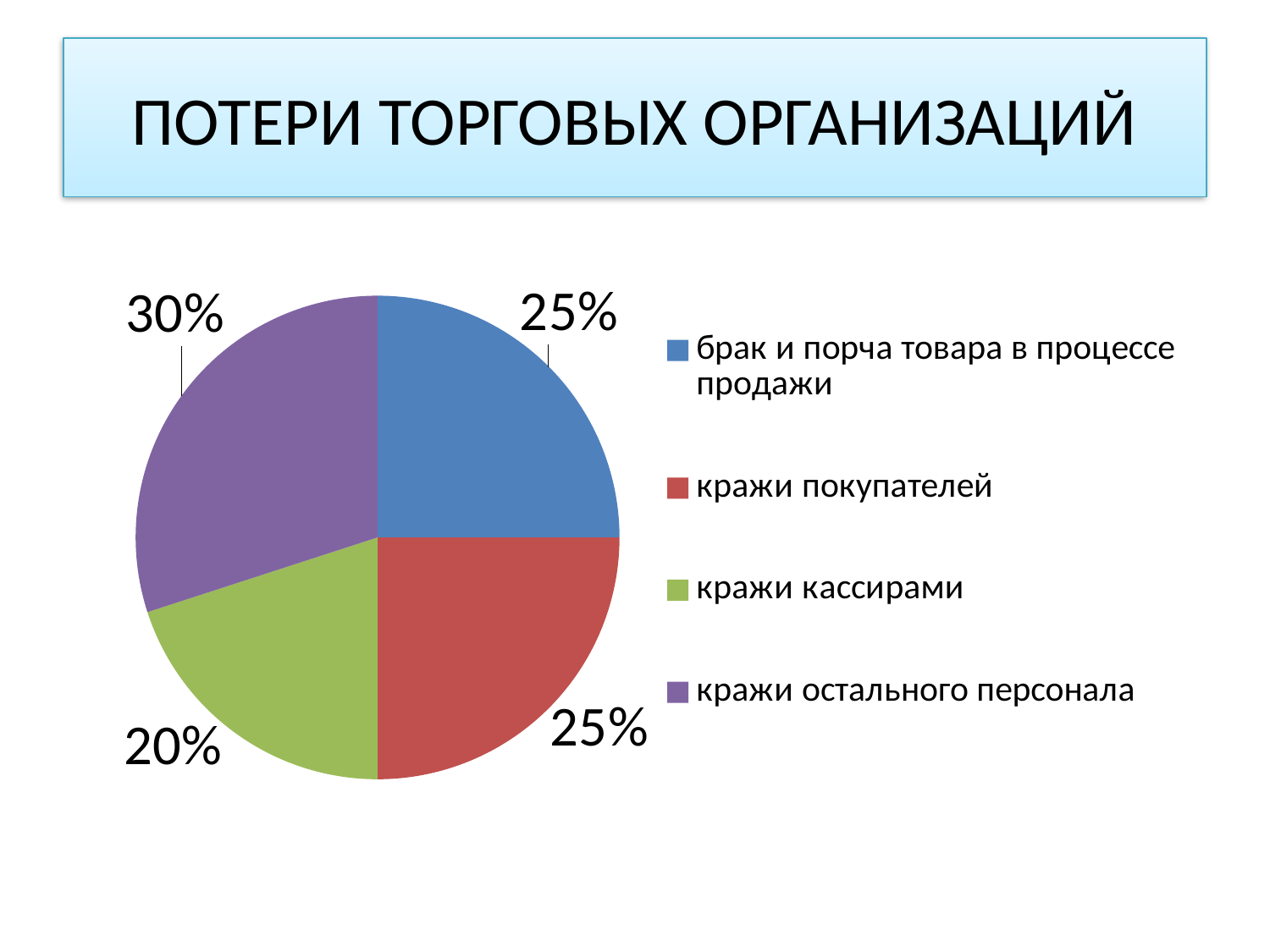
What share of losses is attributed to "кражи остального персонала"? 30% What colour is the slice for "кражи кассирами"? green How many categories does the pie chart show? 4 Which is larger: the share for "кражи покупателей" or the share for "кражи кассирами"? кражи покупателей Which category has the largest share of the pie? кражи остального персонала Which category has the smallest share of the pie? кражи кассирами What share of losses is attributed to "кражи кассирами"? 20% What kind of chart is shown on the slide? pie chart What is the title of the slide containing the chart? ПОТЕРИ ТОРГОВЫХ ОРГАНИЗАЦИЙ What share of losses is attributed to "кражи покупателей"? 25% What is the difference between the share for "кражи остального персонала" and the share for "кражи кассирами"? 10 percentage points What share of losses is attributed to "брак и порча товара в процессе продажи"? 25%